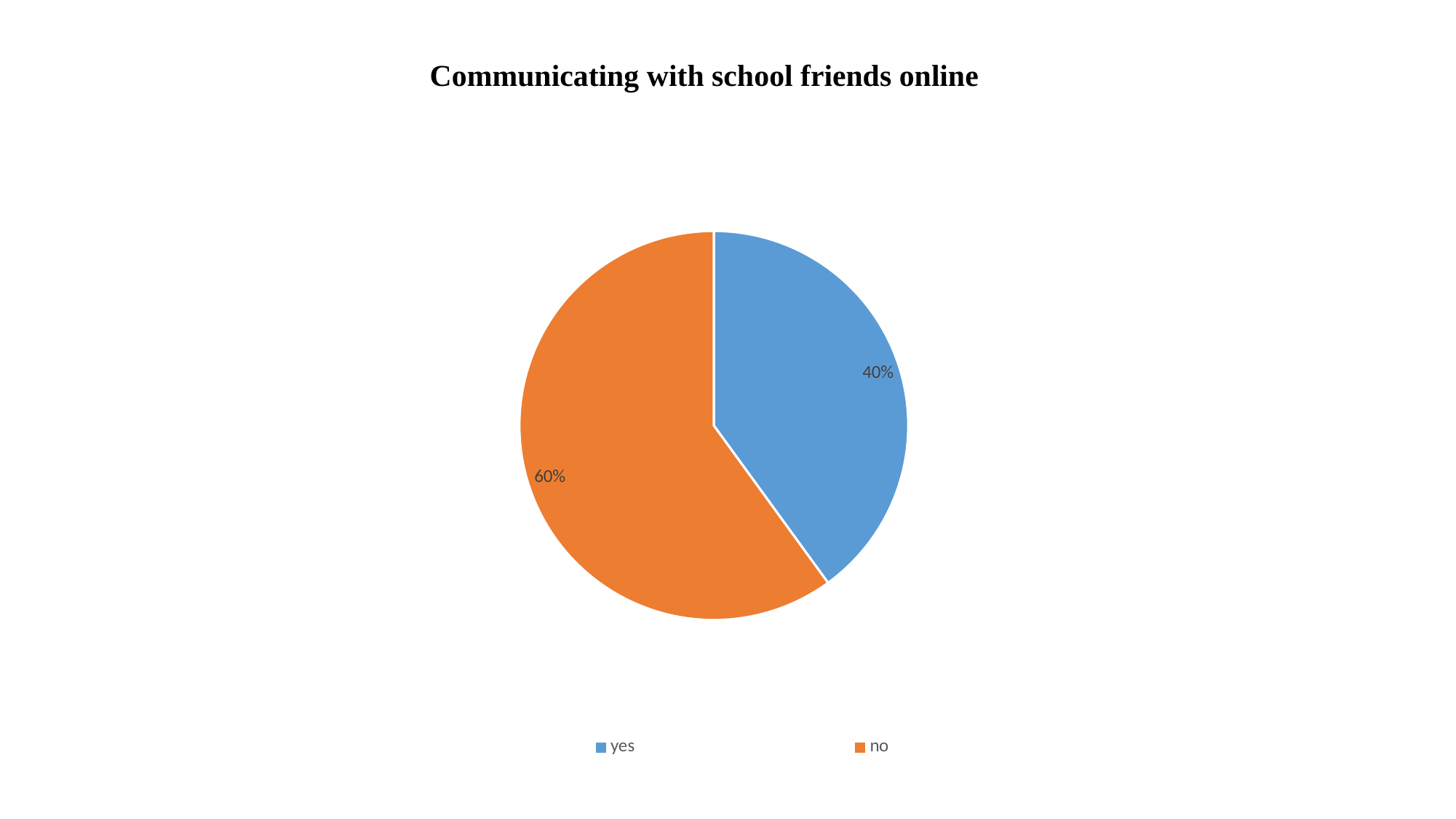
What percentage of the pie is labelled "no"? 60% Which category has the largest share of the pie? no Which is larger, the share for "yes" or the share for "no"? no Which category has the smallest share of the pie? yes How many categories does the pie chart show? 2 What percentage of the pie is labelled "yes"? 40% What share of the pie does the "yes" slice take? 40% How many entries does the legend list? 2 What is the difference in percentage points between the "no" share and the "yes" share? 20% What kind of chart is shown on the slide? pie chart What is the title of the chart? Communicating with school friends online What colour is the "no" slice? orange